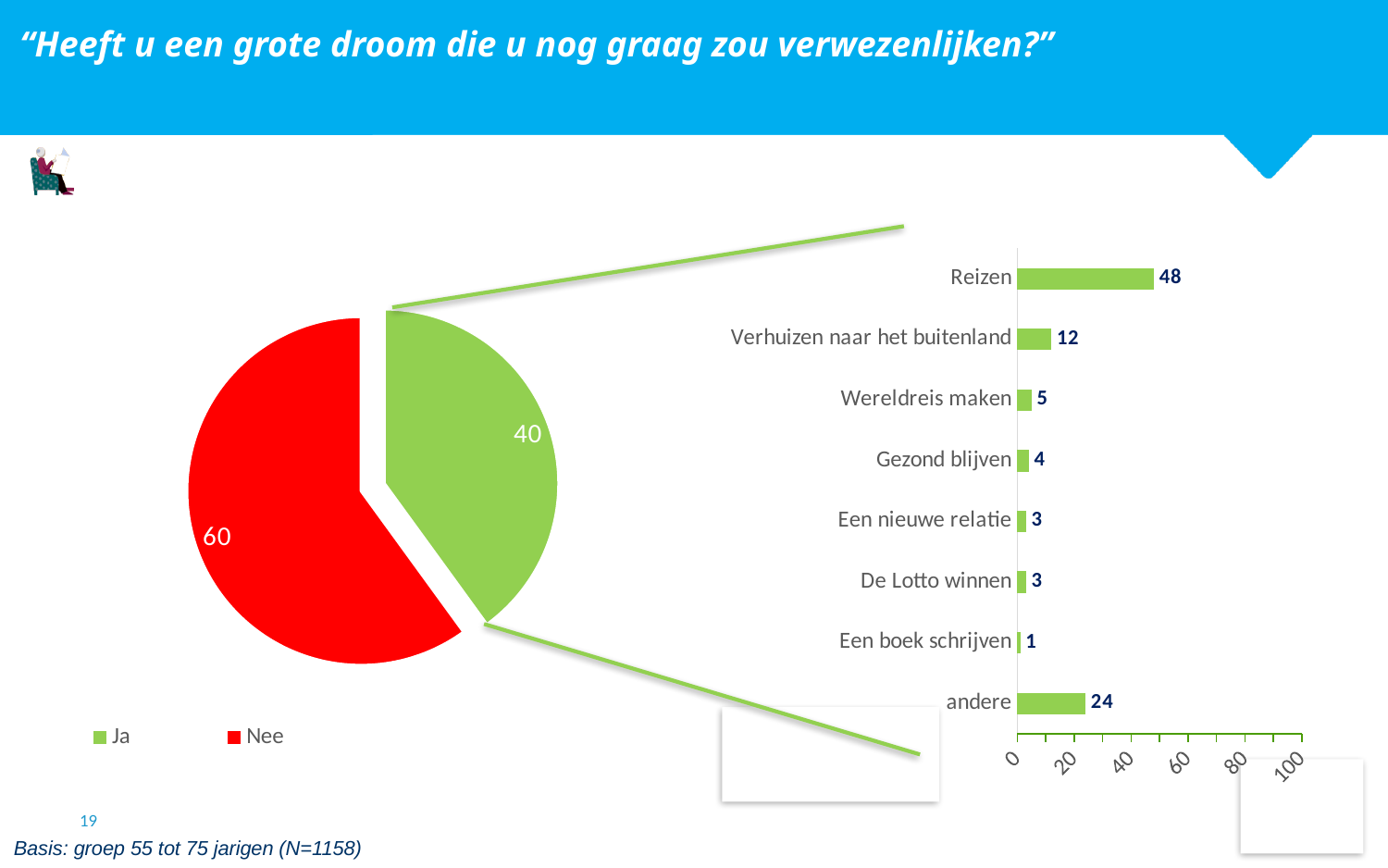
In the pie chart on the left, what is the value for "Ja"? 40 In the pie chart on the left, how many entries does the legend list? 2 In the pie chart on the left, what is the value for "Nee"? 60 In the bar chart on the right, how many categories are shown? 8 In the bar chart on the right, which category has the lowest value? Een boek schrijven In the bar chart on the right, what is the value for "Verhuizen naar het buitenland"? 12 In the pie chart on the left, what colour is the "Nee" slice? Red In the bar chart on the right, which category has the highest value? Reizen What kind of chart is the chart on the right? Bar chart In the bar chart on the right, what is the difference between "Reizen" and "andere"? 24 In the pie chart on the left, which slice is larger, "Ja" or "Nee"? Nee In the bar chart on the right, what is the value for "Reizen"? 48